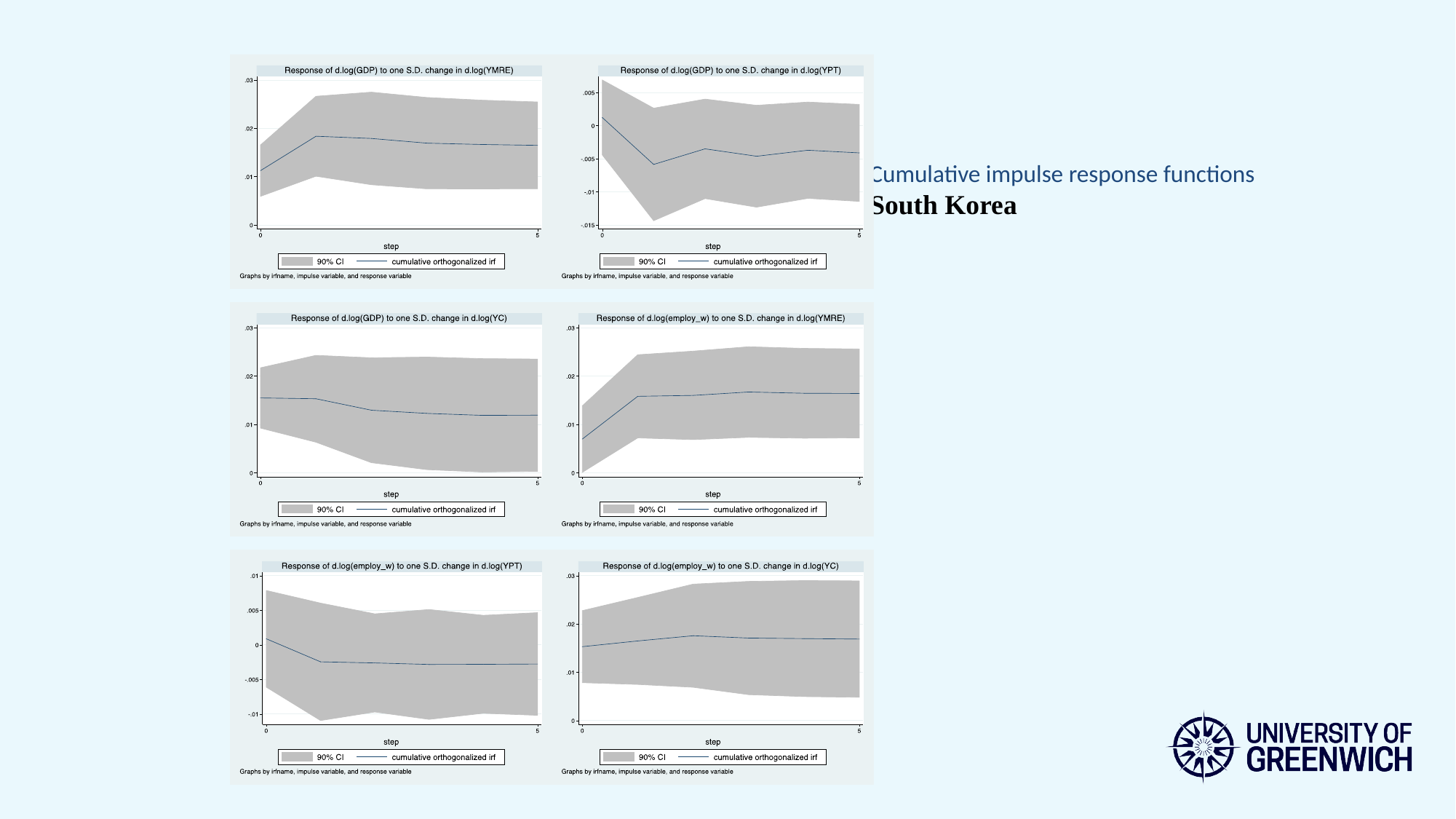
In the middle-right chart (employ_w response to YMRE), is the value of the cumulative orthogonalized irf at step 0 greater or less than .01? less In the top-right chart (GDP response to YPT), does the cumulative orthogonalized irf rise or fall between step 0 and step 1? fall How many entries does the legend of the top-left chart list? 2 In the top-left chart (GDP response to YMRE), is the value of the cumulative orthogonalized irf at step 0 greater or less than .02? less In the top-right chart (GDP response to YPT), is the value of the cumulative orthogonalized irf at step 1 greater or less than 0? less What kind of chart is the top-left chart, 'Response of d.log(GDP) to one S.D. change in d.log(YMRE)'? line chart In the middle-left chart (GDP response to YC), does the cumulative orthogonalized irf rise or fall from step 0 to step 5? fall In the middle-right chart (employ_w response to YMRE), does the cumulative orthogonalized irf rise or fall between step 0 and step 1? rise In the top-left chart (GDP response to YMRE), what does the grey shaded band represent according to the legend? 90% CI How many charts are shown on the slide? 6